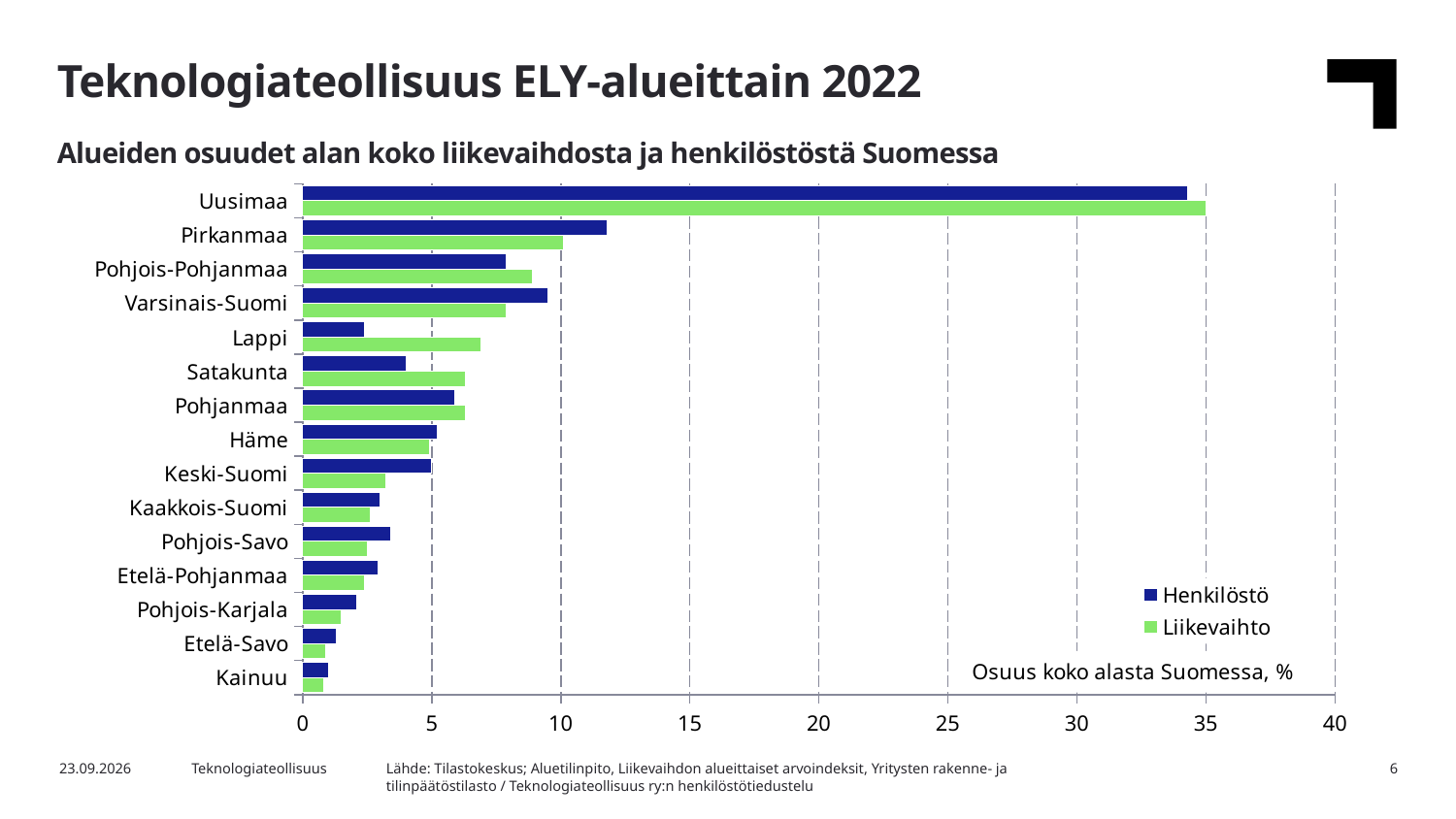
How many regions (categories) are shown on the chart? 15 What kind of chart is shown on the slide? bar chart Is the Henkilöstö value for Lappi greater or less than 5? less Is the Liikevaihto value for Pohjois-Pohjanmaa greater or less than 5? greater For Lappi, which is larger: Henkilöstö or Liikevaihto? Liikevaihto What are the two series named in the legend? Henkilöstö and Liikevaihto How many series does the legend list? 2 Which region has the lowest Henkilöstö share? Kainuu Which region has the highest Henkilöstö share? Uusimaa Which region has the highest Liikevaihto share? Uusimaa Is the Liikevaihto value for Uusimaa greater or less than 30? greater For Varsinais-Suomi, which is larger: Henkilöstö or Liikevaihto? Henkilöstö